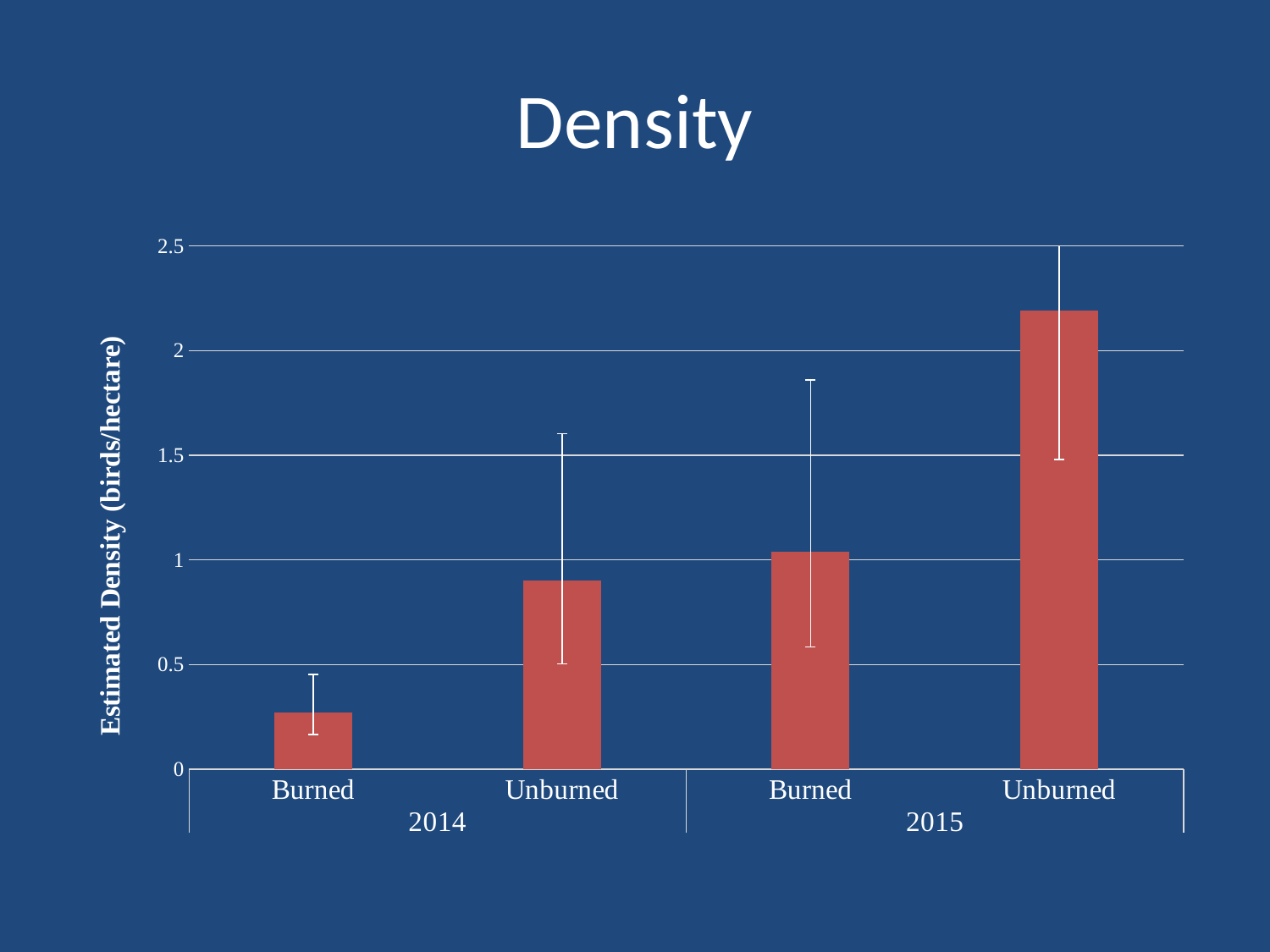
Which has a higher estimated density, Burned in 2014 or Burned in 2015? Burned in 2015 Do the bar values rise or fall from left to right across the chart? rise Which has a higher estimated density, Unburned in 2014 or Unburned in 2015? Unburned in 2015 Is the estimated density for Unburned in 2015 greater or less than 2? greater Which bar has the lowest estimated density? Burned 2014 What kind of chart is shown on the slide? bar chart Is the estimated density for Burned in 2014 greater or less than 0.5? less Is the estimated density for Burned in 2015 greater or less than 1.5? less Which bar has the highest estimated density? Unburned 2015 What is the label on the vertical axis of the chart? Estimated Density (birds/hectare) How many bars are plotted in the chart? 4